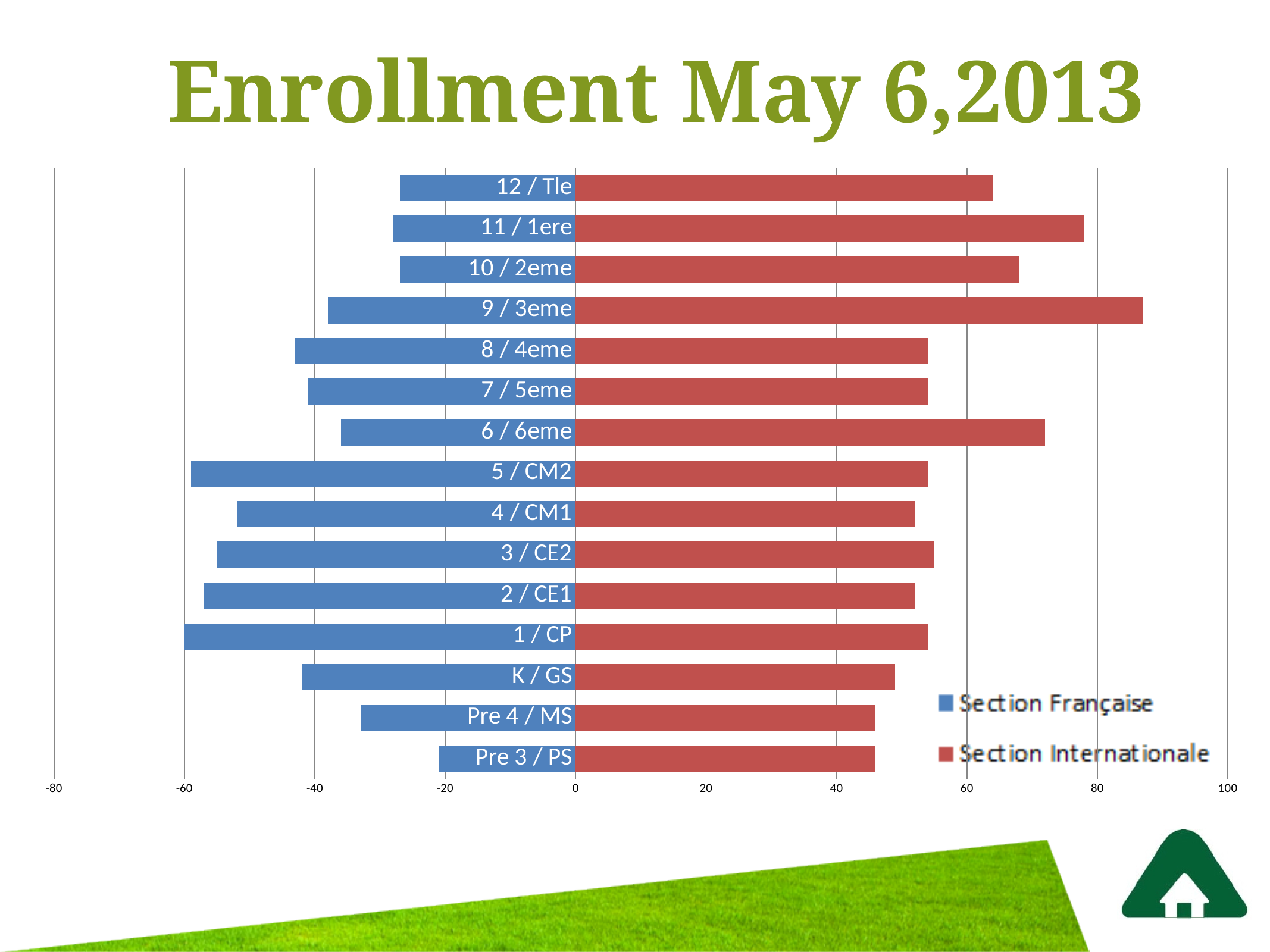
Is the Section Internationale value for Pre 3 / PS greater or less than 40? greater Is the Section Internationale value for 9 / 3eme greater or less than 80? greater How many grade categories are shown on the chart? 15 Is the Section Internationale value for 11 / 1ere greater or less than 60? greater How many series does the legend list? 2 What is the title of the chart on the slide? Enrollment May 6,2013 Which grade has the larger Section Internationale enrollment, 11 / 1ere or 12 / Tle? 11 / 1ere Which grade has the highest Section Internationale enrollment? 9 / 3eme Which colour represents Section Internationale in the chart? Red What kind of chart is shown on the slide? Bar chart Which grade has the smallest Section Française bar? Pre 3 / PS Which grade has the longer Section Française bar, 5 / CM2 or 6 / 6eme? 5 / CM2